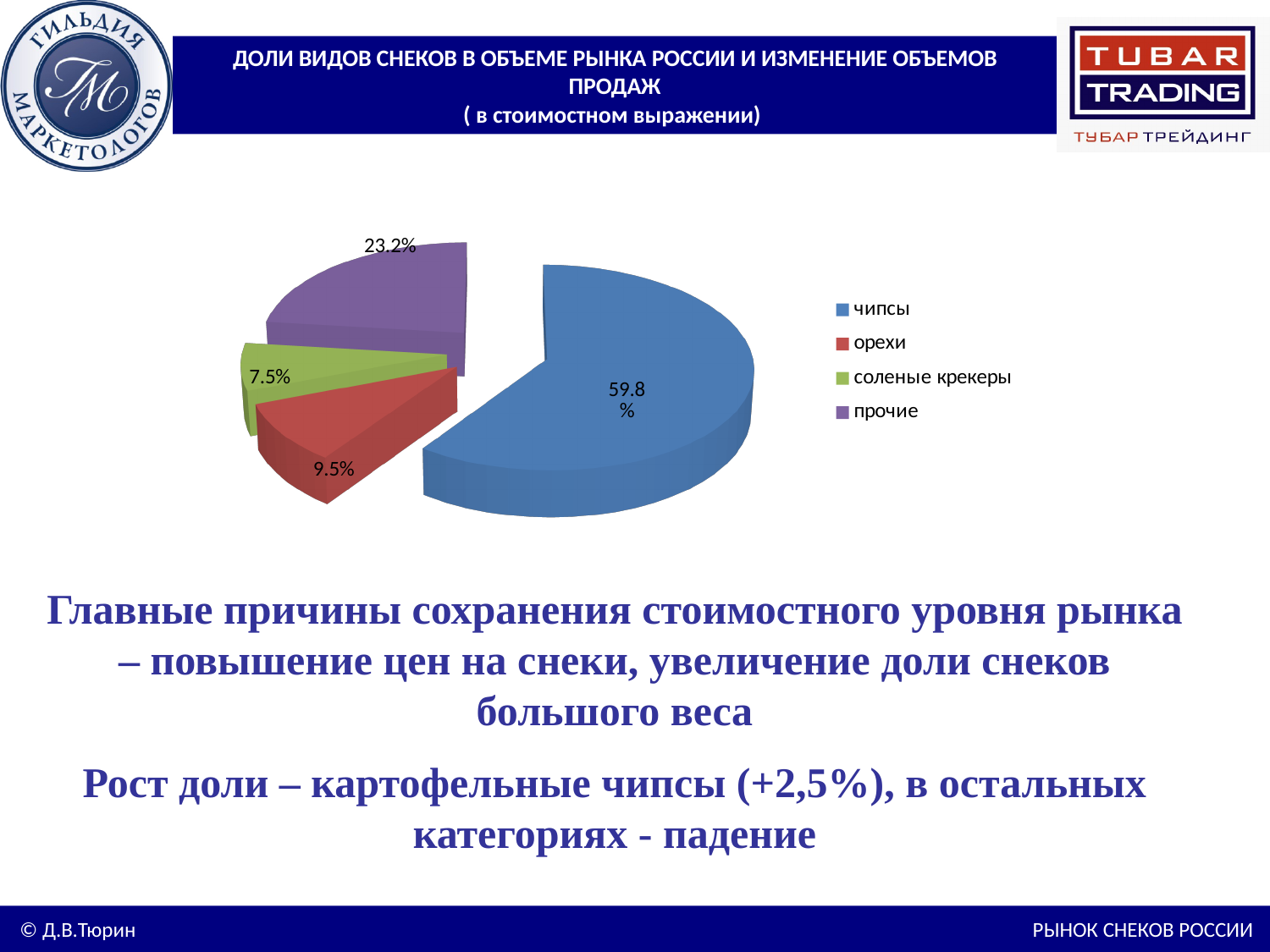
What share of the pie does the прочие slice have? 23.2% Which category has the smallest slice of the pie? соленые крекеры What kind of chart is shown on the slide? pie chart What colour is the чипсы slice in the pie chart? blue What share of the pie does the чипсы slice have? 59.8% Which slice is larger, прочие or орехи? прочие What share of the pie does the соленые крекеры slice have? 7.5% What is the difference in percentage points between the чипсы slice and the прочие slice? 36.6% What is the difference in percentage points between the орехи slice and the соленые крекеры slice? 2.0% Which category has the largest slice of the pie? чипсы How many slices does the pie chart have? 4 What share of the pie does the орехи slice have? 9.5%